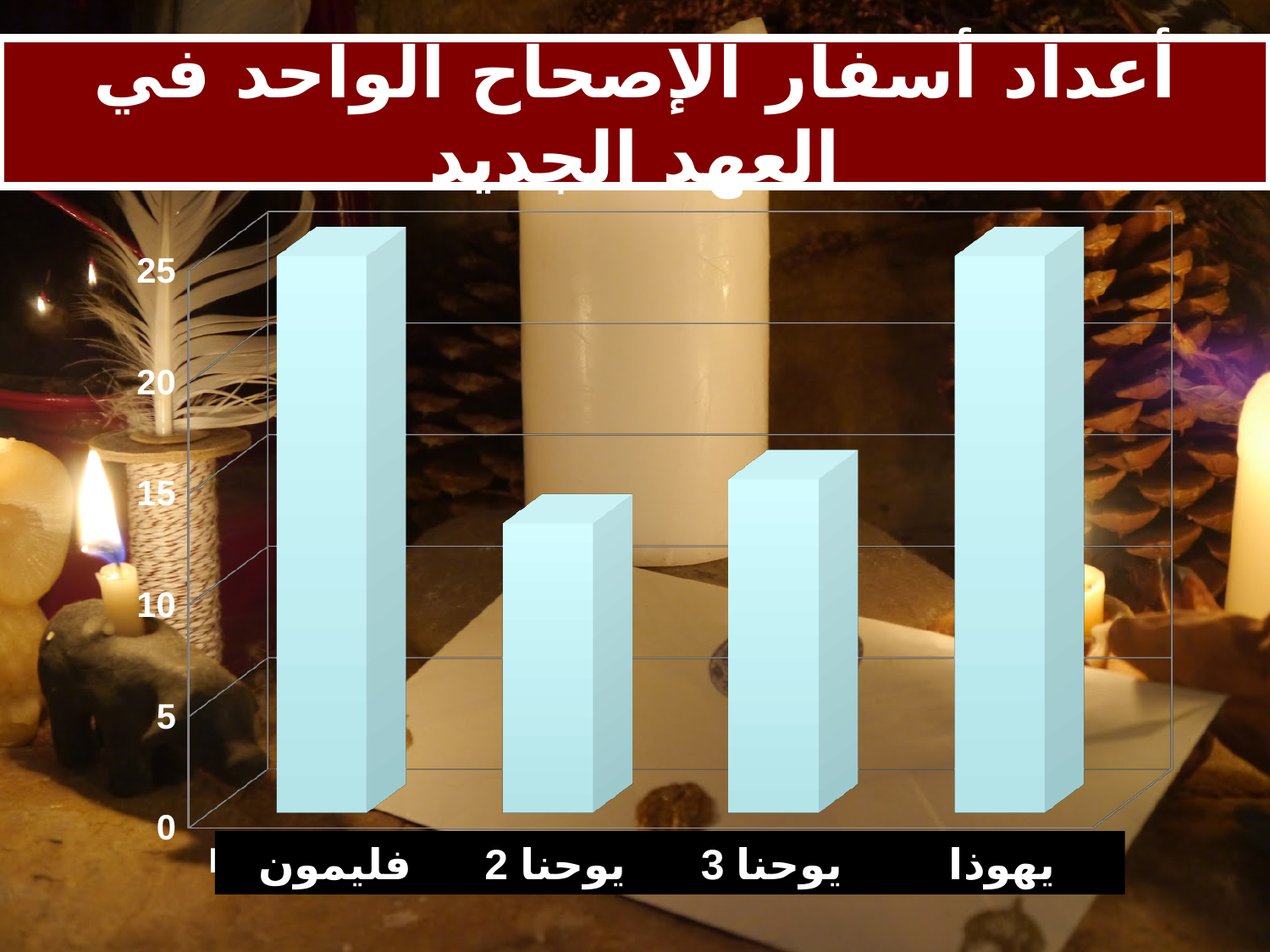
Is the value for يوحنا 2 greater or less than 15? less How many categories (books) are shown on the x axis of the chart? 4 Which is larger, the value for يوحنا 2 or the value for يوحنا 3? يوحنا 3 Which category has the lowest bar in the chart? يوحنا 2 Is the value for فليمون greater or less than 20? greater Is the value for يوحنا 3 greater or less than 20? less What is the title of the chart on the slide? أعداد أسفار الإصحاح الواحد في العهد الجديد What kind of chart is shown on the slide? bar chart Which is larger, the value for فليمون or the value for يوحنا 2? فليمون